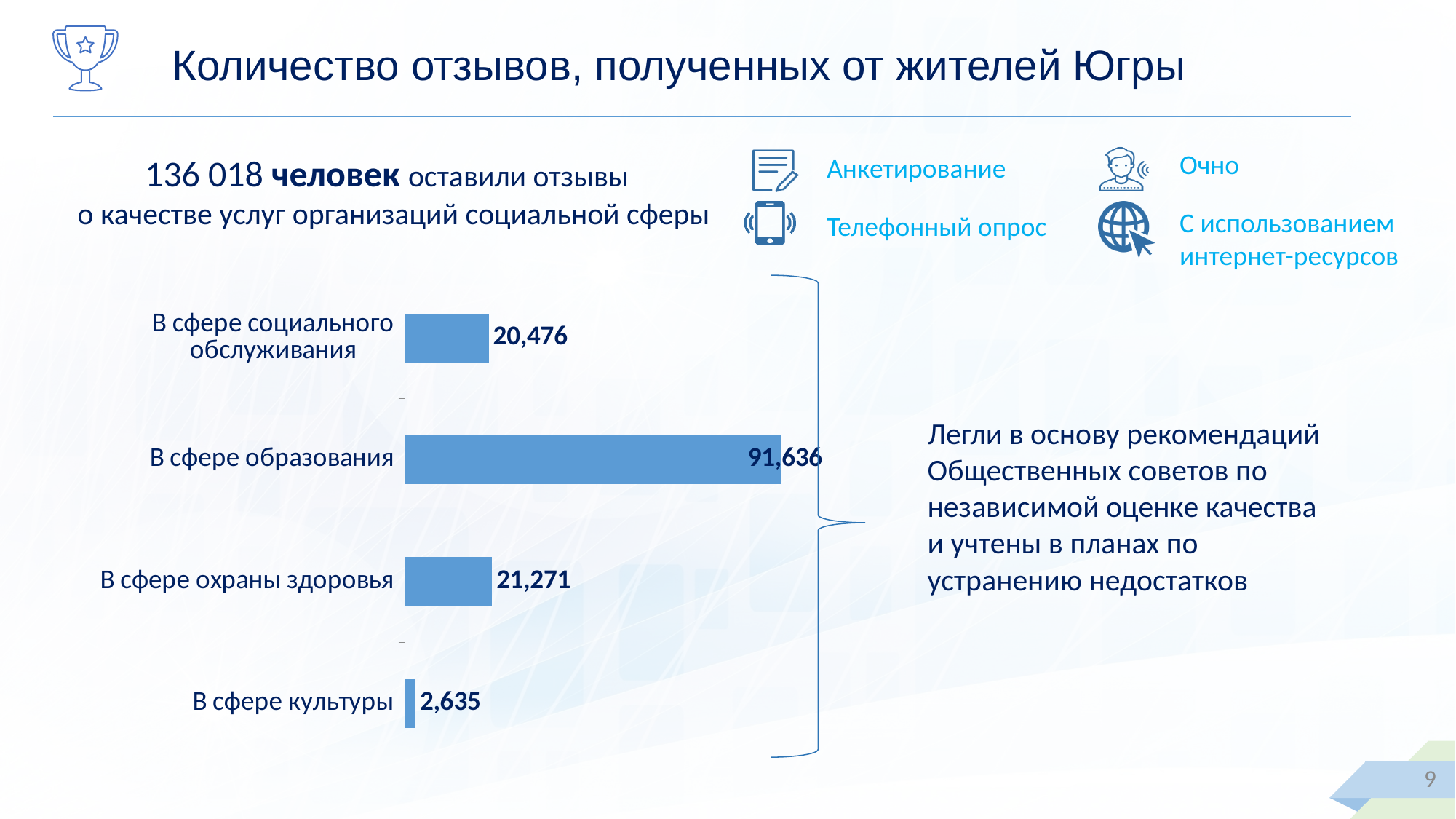
What is the value for «В сфере социального обслуживания»? 20,476 Which is larger: the value for «В сфере образования» or the value for «В сфере охраны здоровья»? В сфере образования Which category has the highest value? В сфере образования What kind of chart is shown on the slide? Bar chart What is the value for «В сфере культуры»? 2,635 What is the value for «В сфере охраны здоровья»? 21,271 What colour are the bars in the chart? Blue How many categories are shown in the chart? 4 Which category has the lowest value? В сфере культуры What is the difference between the values for «В сфере охраны здоровья» and «В сфере культуры»? 18,636 What is the difference between the values for «В сфере образования» and «В сфере социального обслуживания»? 71,160 What is the value for «В сфере образования»? 91,636